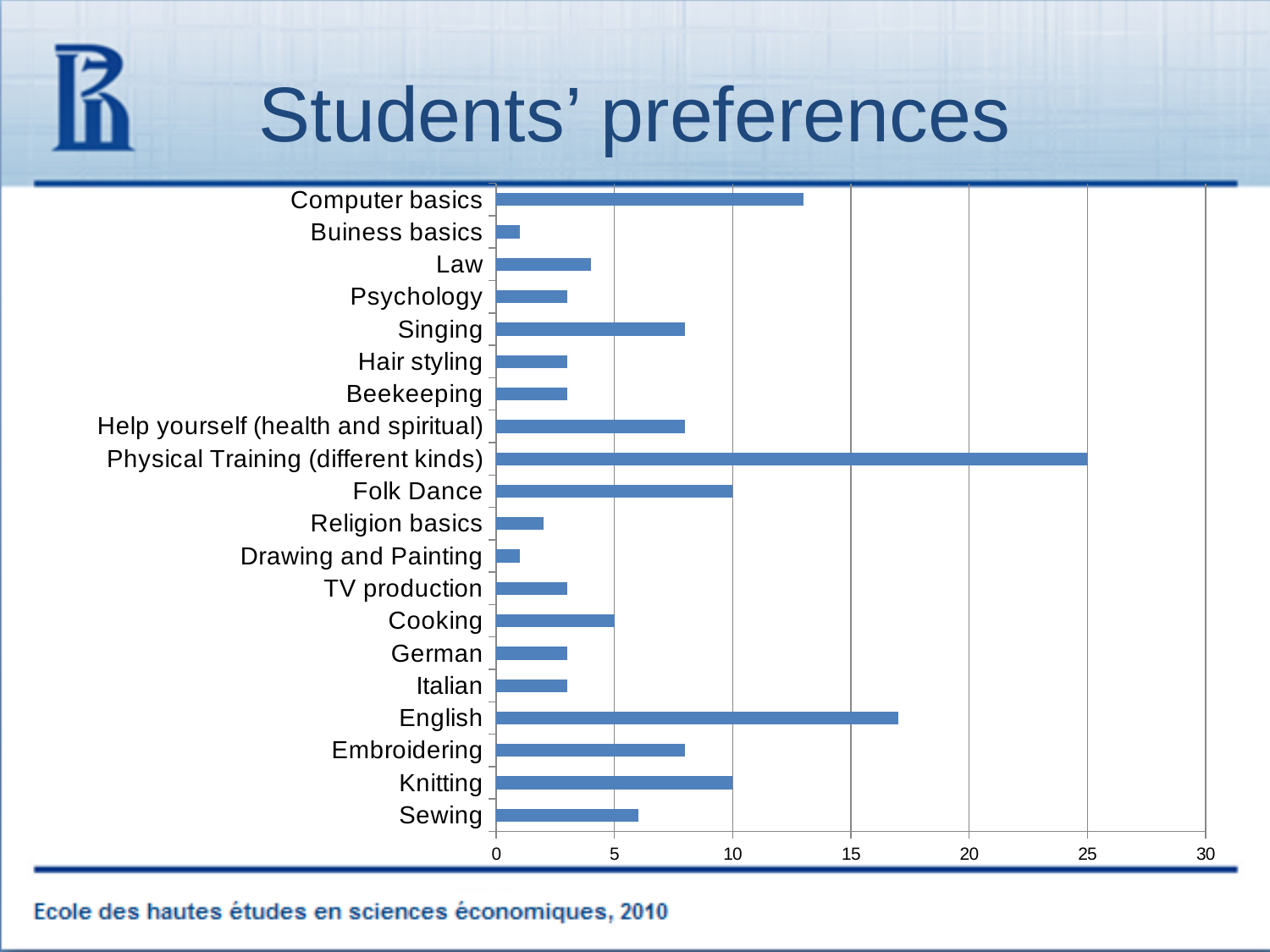
Which is larger, the value for English or the value for Computer basics? English How many categories are plotted in the chart? 20 Which category has the highest value? Physical Training (different kinds) What is the value for Folk Dance? 10 What is the value for Physical Training (different kinds)? 25 Is the value for Sewing greater or less than 5? greater What is the title of the chart? Students' preferences Is the value for Law greater or less than 5? less What is the value for Cooking? 5 What kind of chart is shown on the slide? bar chart What is the difference between the values for Physical Training (different kinds) and Knitting? 15 Is the value for English greater or less than 15? greater